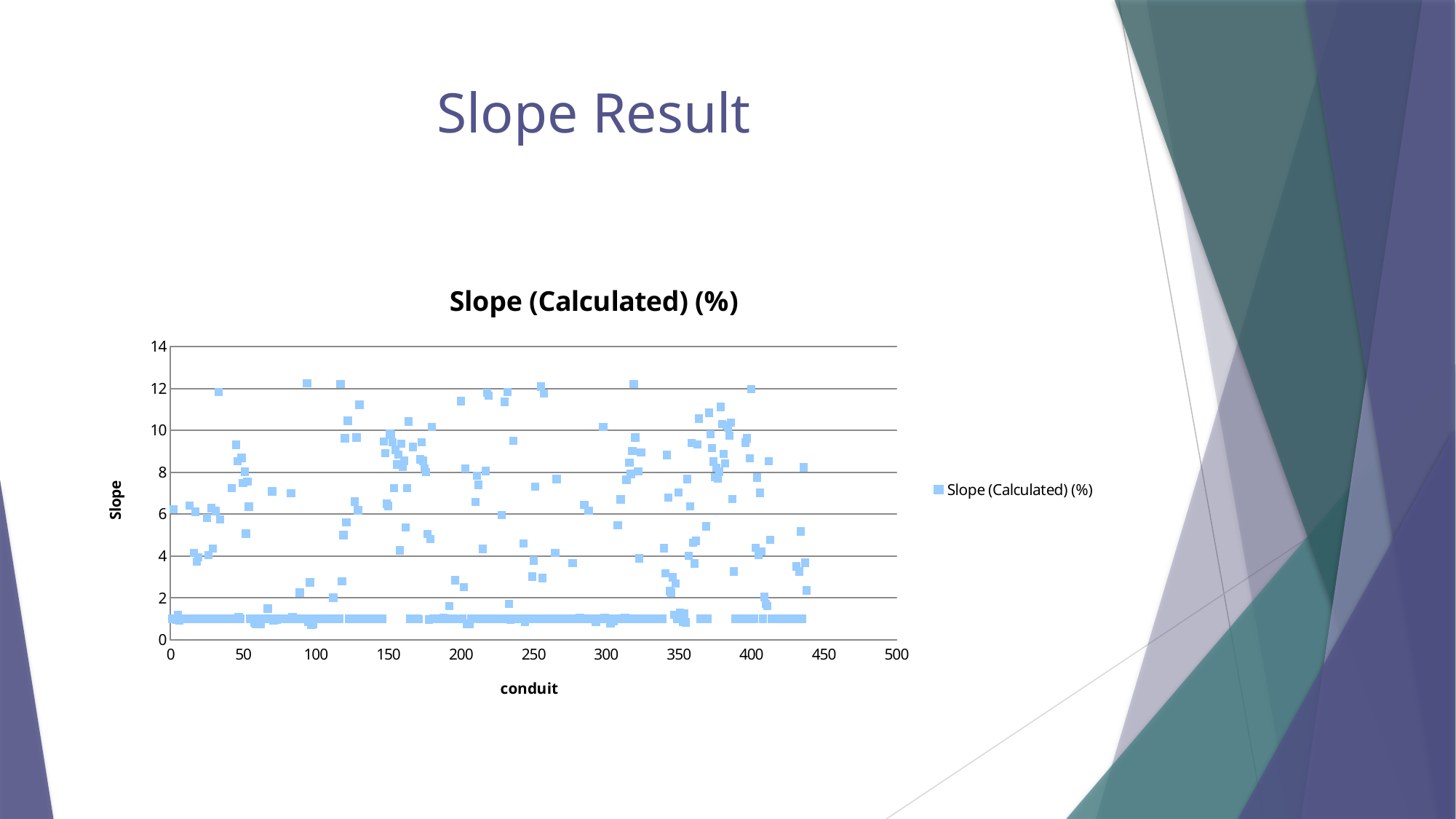
Are there any points plotted beyond 450 on the x axis? No Is the highest plotted slope value greater or less than 12? greater What kind of chart is shown on the slide? scatter chart What is the title of the chart? Slope (Calculated) (%) Is the lowest plotted slope value greater or less than 2? less How many series does the chart legend list? 1 What is the maximum value shown on the x axis of the chart? 500 What is the maximum value shown on the y axis of the chart? 14 What is the label of the x axis of the chart? conduit